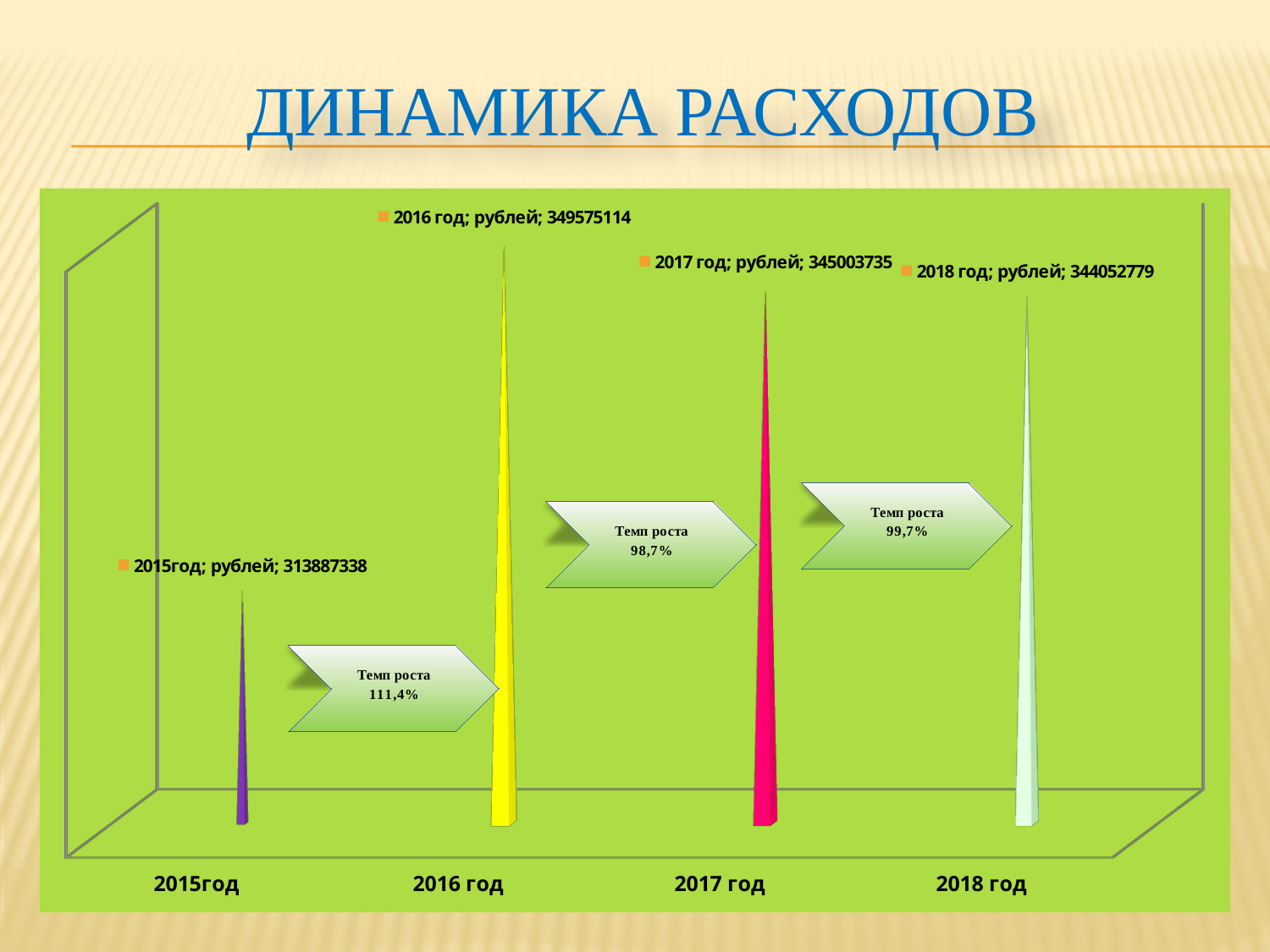
What is the value for 2015год? 313887338 What is the difference between the values for 2016 год and 2015год? 35687776 Which is larger, the value for 2017 год or the value for 2018 год? 2017 год What kind of chart is shown on the slide? bar chart What is the value for 2017 год? 345003735 Which year has the highest value? 2016 год What is the difference between the values for 2017 год and 2018 год? 950956 Which year has the lowest value? 2015год What is the value for 2018 год? 344052779 What is the value for 2016 год? 349575114 How many years are shown on the chart? 4 What is the title of the slide? ДИНАМИКА РАСХОДОВ